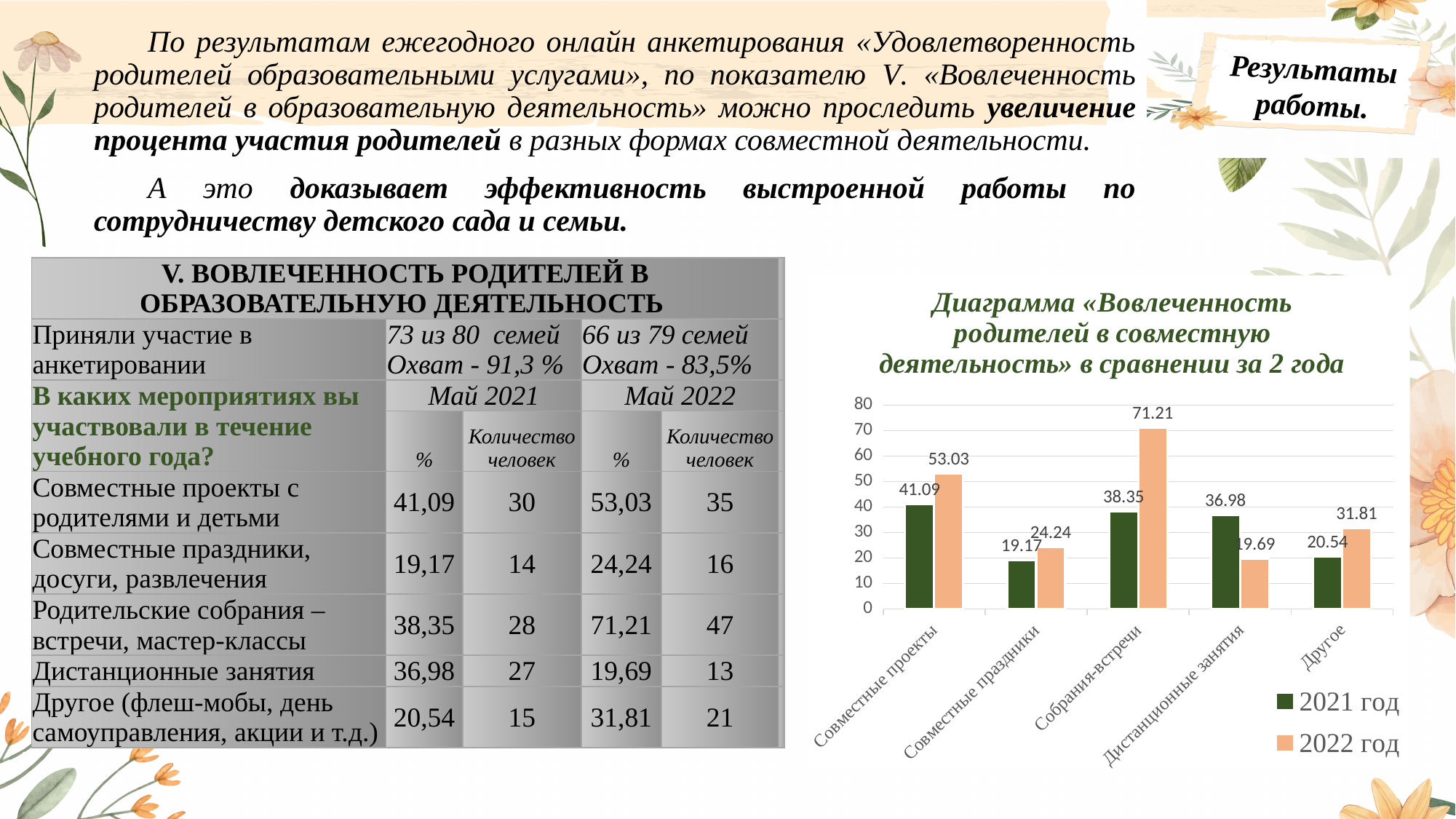
Which category has the highest value for 2022 год? Собрания-встречи How many series does the chart legend list? 2 What colour are the bars for the 2022 год series? orange Which category has the lowest value for 2021 год? Совместные праздники Is the value for 2022 год in Совместные проекты greater or less than 50? greater How many categories are shown on the x axis of the chart? 5 What is the value for 2022 год in the category Собрания-встречи? 71.21 What type of chart is shown on the slide? bar chart What is the value for 2022 год in the category Другое? 31.81 What is the value for 2021 год in the category Совместные проекты? 41.09 For Дистанционные занятия, which series has the larger value, 2021 год or 2022 год? 2021 год What is the difference between the 2022 год and 2021 год values for Собрания-встречи? 32.86